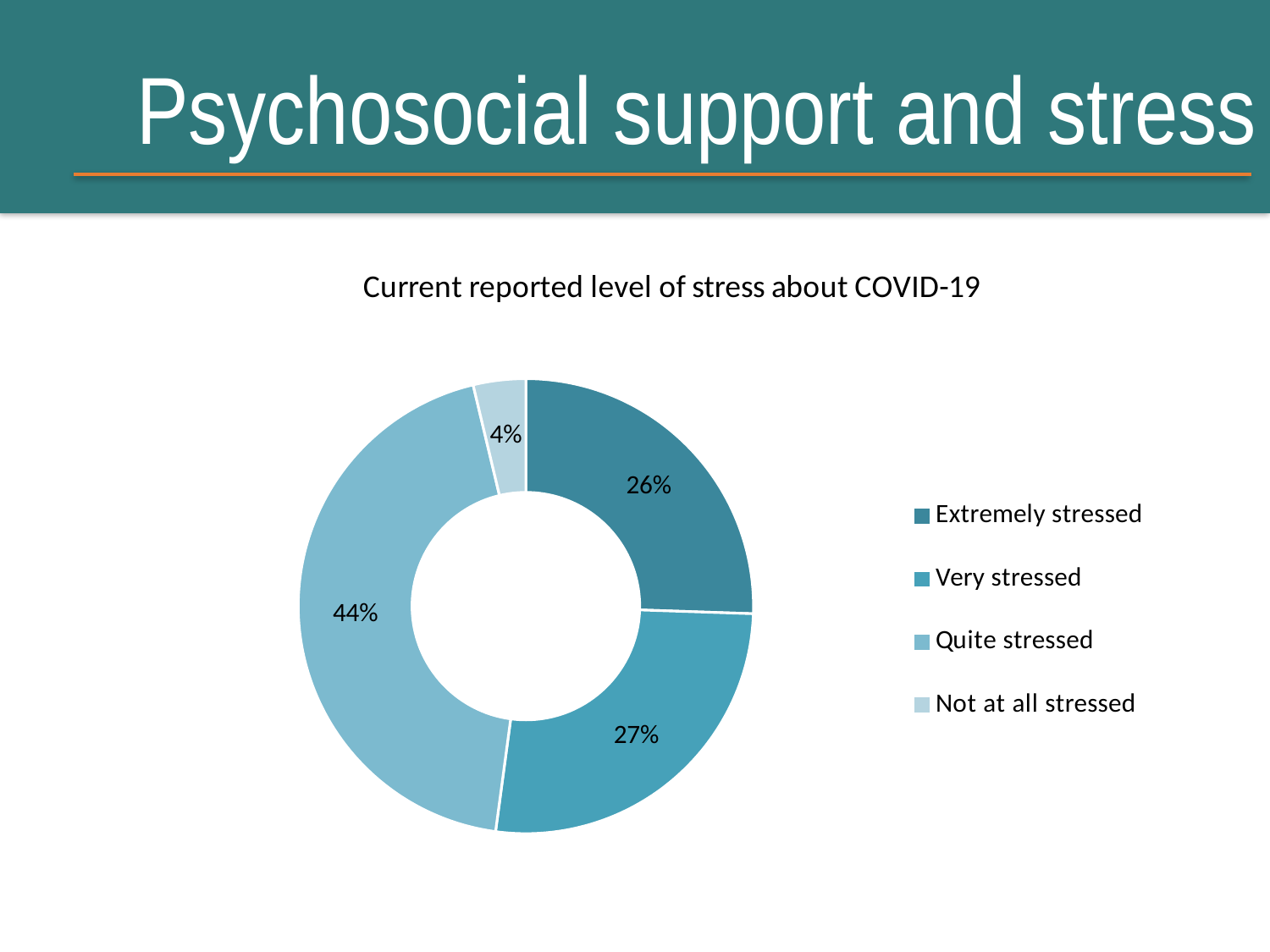
What is the title of the chart? Current reported level of stress about COVID-19 What percentage of respondents reported being not at all stressed? 4% How many stress-level categories are shown in the chart? 4 What percentage of respondents reported being quite stressed? 44% Which stress level has the smallest share of respondents? Not at all stressed Which is larger: the share for very stressed or the share for extremely stressed? Very stressed What is the difference in percentage points between the quite stressed and extremely stressed shares? 18 What type of chart is used to show the reported level of stress about COVID-19? Doughnut (pie) chart What percentage of respondents reported being extremely stressed about COVID-19? 26% Which stress level has the largest share of respondents? Quite stressed What is the combined share of respondents who reported being extremely stressed or very stressed? 53% What percentage of respondents reported being very stressed? 27%